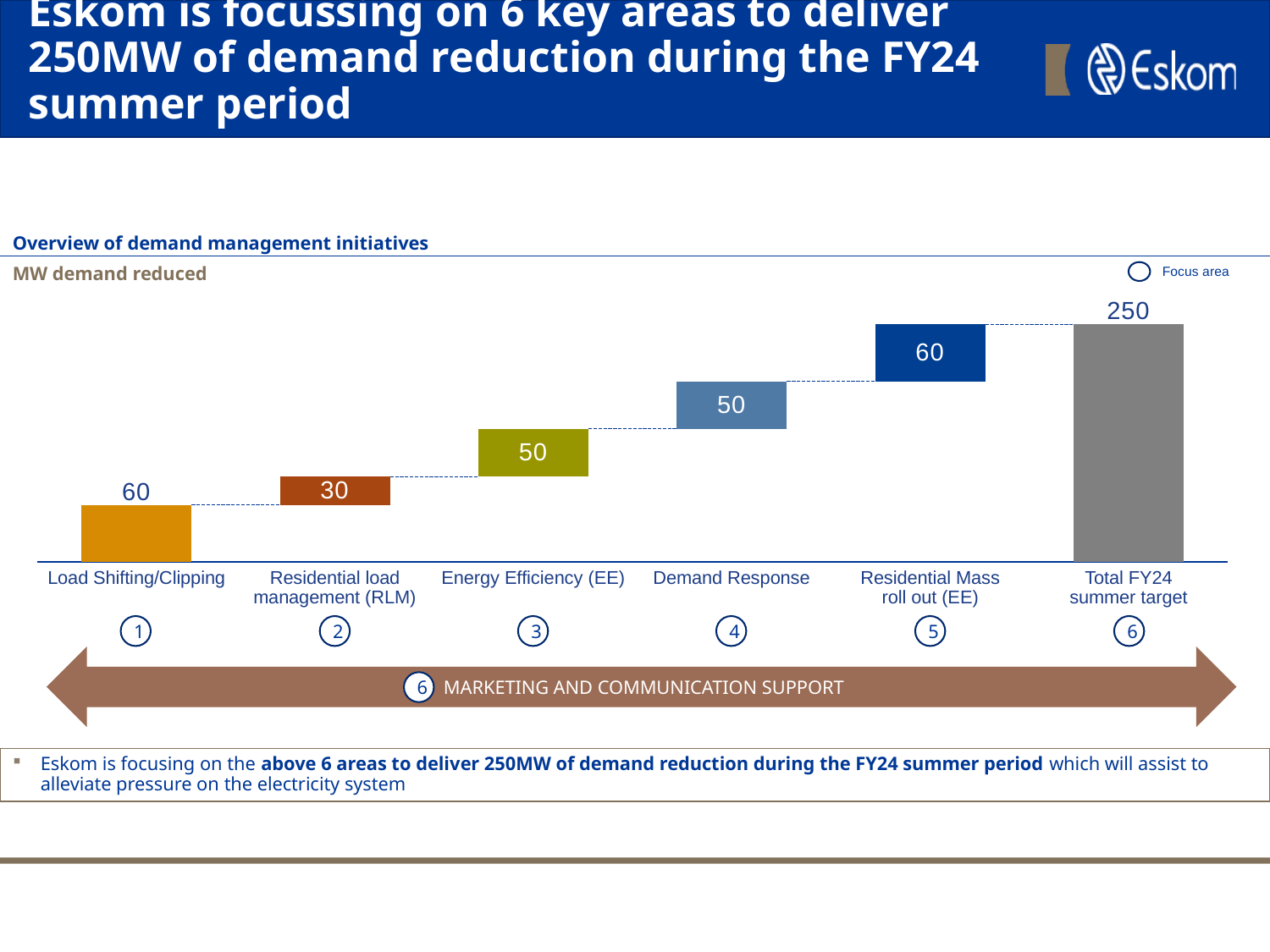
What is the title of the chart? Overview of demand management initiatives How many categories are shown along the x axis of the chart? 6 Which is larger, the value for Energy Efficiency (EE) or the value for Residential load management (RLM)? Energy Efficiency (EE) Which initiative has the lowest MW demand reduced value? Residential load management (RLM) What is the MW demand reduced value for Load Shifting/Clipping? 60 What is the Total FY24 summer target shown on the chart? 250 What is the value shown for Energy Efficiency (EE)? 50 What kind of chart is shown on the slide? bar chart What is the value shown for Residential load management (RLM)? 30 What is the value shown for Residential Mass roll out (EE)? 60 What is the difference between the values for Load Shifting/Clipping and Residential load management (RLM)? 30 What is the value shown for Demand Response? 50